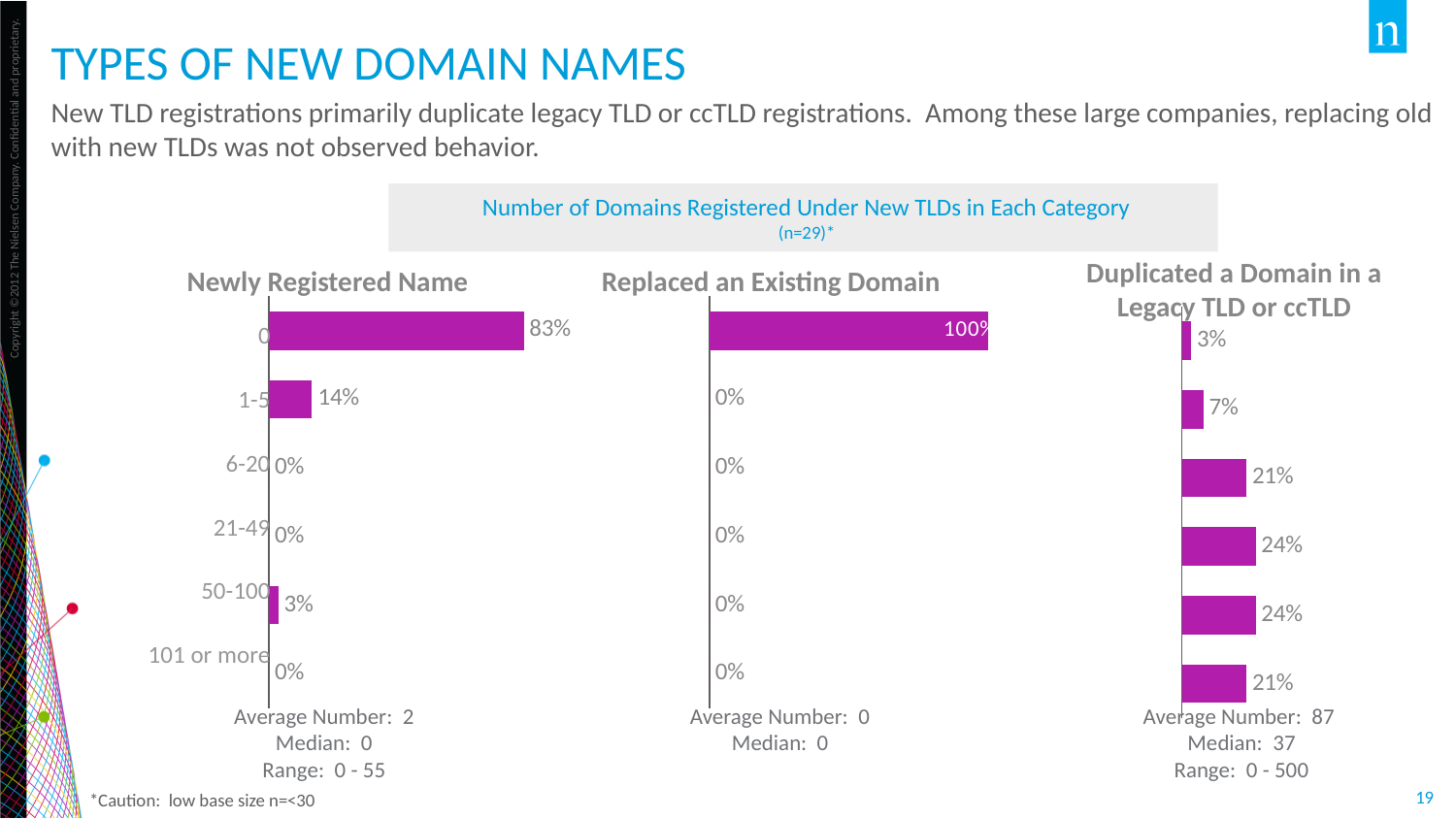
In the 'Newly Registered Name' chart, what is the difference between the '0' and '1-5' values? 69% In the 'Newly Registered Name' chart, what is the value for the '0' category? 83% In the 'Newly Registered Name' chart, what is the value for the '1-5' category? 14% In the 'Replaced an Existing Domain' chart, what is the value of the top bar? 100% In the 'Duplicated a Domain in a Legacy TLD or ccTLD' chart, what is the value of the top bar? 3% How many categories are shown in the 'Newly Registered Name' chart? 6 What is the average number shown below the 'Duplicated a Domain in a Legacy TLD or ccTLD' chart? 87 In the 'Newly Registered Name' chart, what is the value for the '50-100' category? 3% In the 'Newly Registered Name' chart, which category has the highest value? 0 In the 'Duplicated a Domain in a Legacy TLD or ccTLD' chart, what is the value of the bottom bar? 21% In the 'Duplicated a Domain in a Legacy TLD or ccTLD' chart, which is larger: the second bar from the top or the third bar from the top? the third bar from the top What type of chart is the 'Replaced an Existing Domain' chart? bar chart